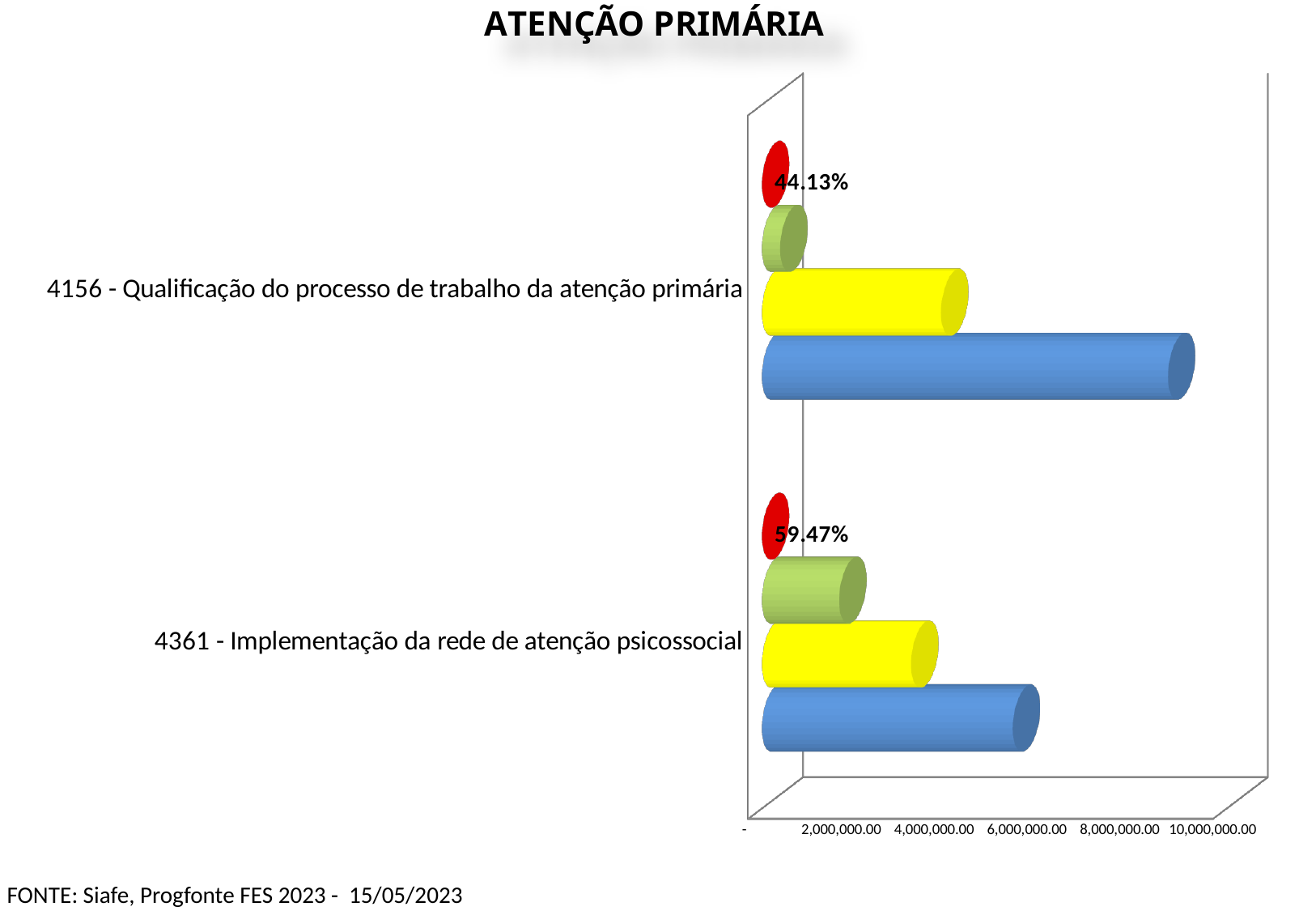
How many categories are shown on the chart? 2 Which category has the longer green bar? 4361 - Implementação da rede de atenção psicossocial What percentage label is shown for '4361 - Implementação da rede de atenção psicossocial'? 59.47% What kind of chart is shown on the slide? bar chart What percentage label is shown for '4156 - Qualificação do processo de trabalho da atenção primária'? 44.13% How many bars are shown for each category? 4 Is the value of the blue bar for '4361 - Implementação da rede de atenção psicossocial' greater or less than 8,000,000.00? less Is the value of the green bar for '4156 - Qualificação do processo de trabalho da atenção primária' greater or less than 2,000,000.00? less What is the title of the chart? ATENÇÃO PRIMÁRIA Which category has the higher percentage label? 4361 - Implementação da rede de atenção psicossocial Which category has the longer blue bar? 4156 - Qualificação do processo de trabalho da atenção primária Is the value of the blue bar for '4156 - Qualificação do processo de trabalho da atenção primária' greater or less than 8,000,000.00? greater